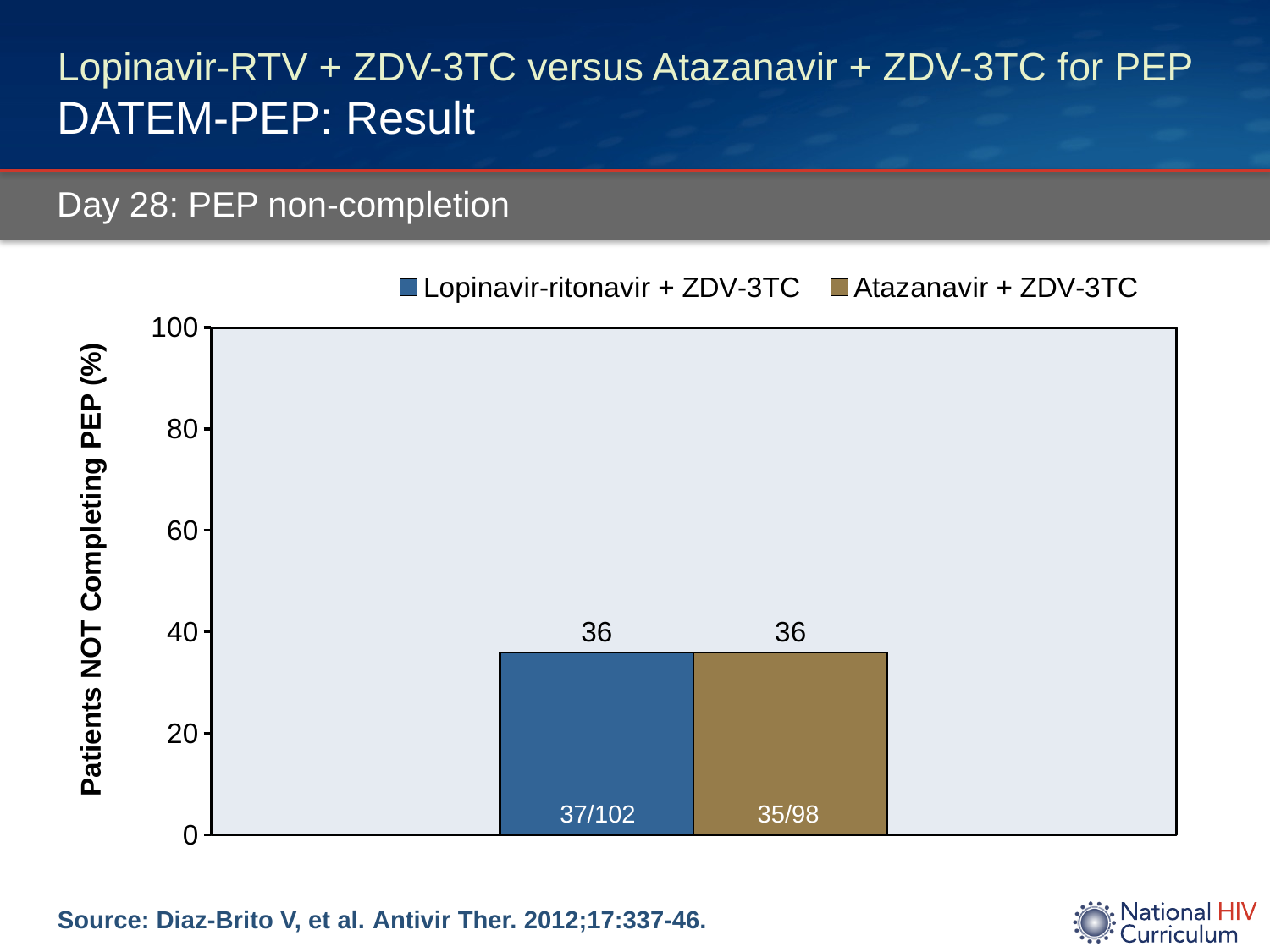
What fraction is printed inside the Lopinavir-ritonavir + ZDV-3TC bar? 37/102 What percentage of patients did not complete PEP in the Atazanavir + ZDV-3TC group? 36 What percentage of patients did not complete PEP in the Lopinavir-ritonavir + ZDV-3TC group? 36 What is the difference in PEP non-completion percentage between the Lopinavir-ritonavir + ZDV-3TC and Atazanavir + ZDV-3TC groups? 0 What is the maximum value shown on the y-axis? 100 What fraction is printed inside the Atazanavir + ZDV-3TC bar? 35/98 What kind of chart is shown on the slide? Bar chart How many series does the legend list? 2 Is the PEP non-completion value for the Atazanavir + ZDV-3TC group greater or less than 40? less What is the label of the y-axis? Patients NOT Completing PEP (%) Is the PEP non-completion value for the Lopinavir-ritonavir + ZDV-3TC group greater or less than 20? greater How many bars are plotted in the chart? 2